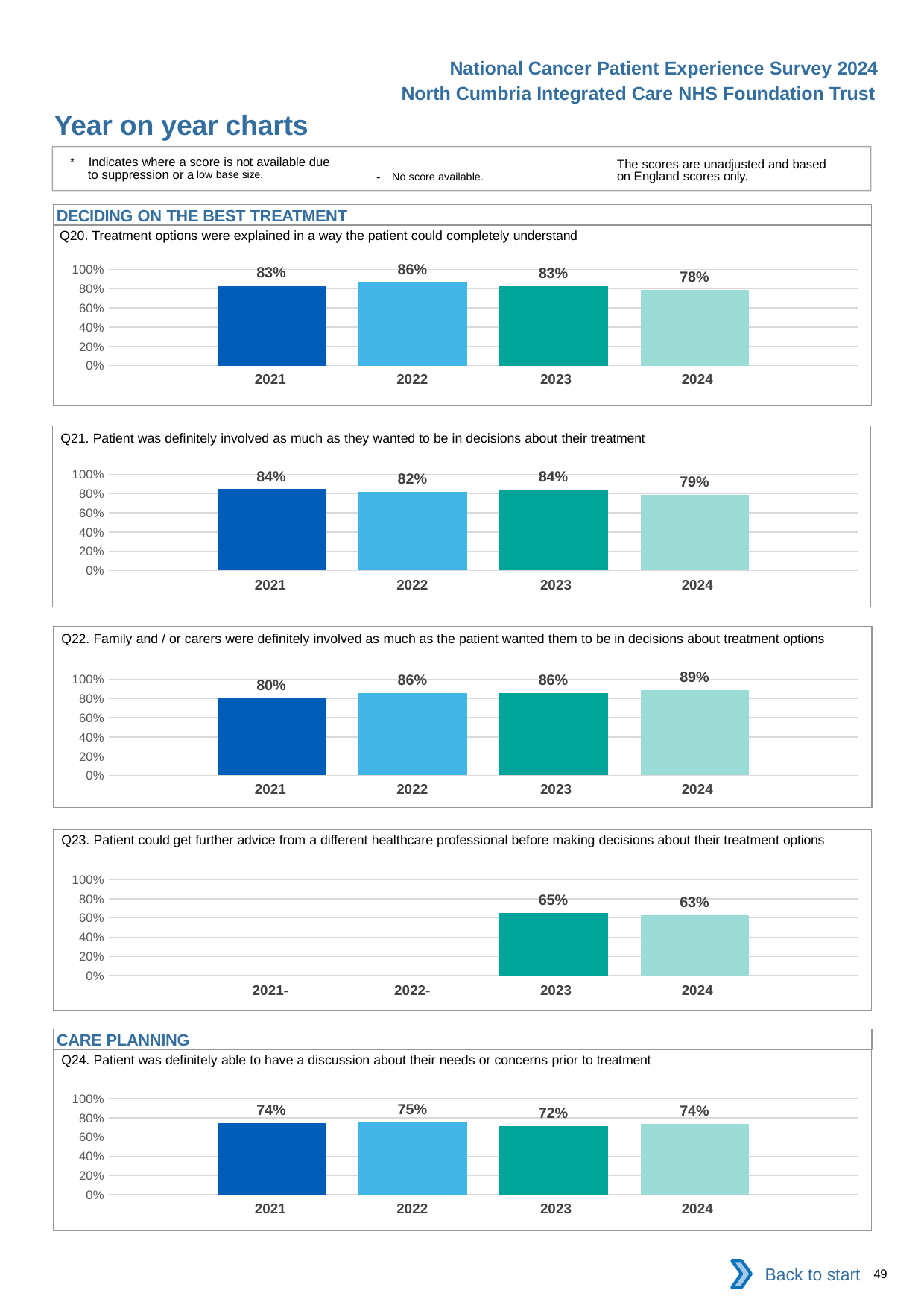
In the Q20 chart, which year has the lowest value? 2024 In the Q23 chart, which is larger, the value for 2023 or 2024? 2023 In the Q22 chart, what is the value for 2021? 80% In the Q24 chart, what is the difference between the 2022 and 2023 values? 3% What kind of chart is the Q24 chart? bar chart In the Q22 chart, which year has the highest value? 2024 In the Q20 chart, what is the value for 2022? 86% In the Q23 chart, how many years have a plotted bar? 2 In the Q23 chart, is the value for 2023 greater or less than 60%? greater In the Q21 chart, what is the difference between the 2021 and 2024 values? 5% In the Q24 chart, what is the value for 2023? 72% In the Q21 chart, what is the value for 2022? 82%